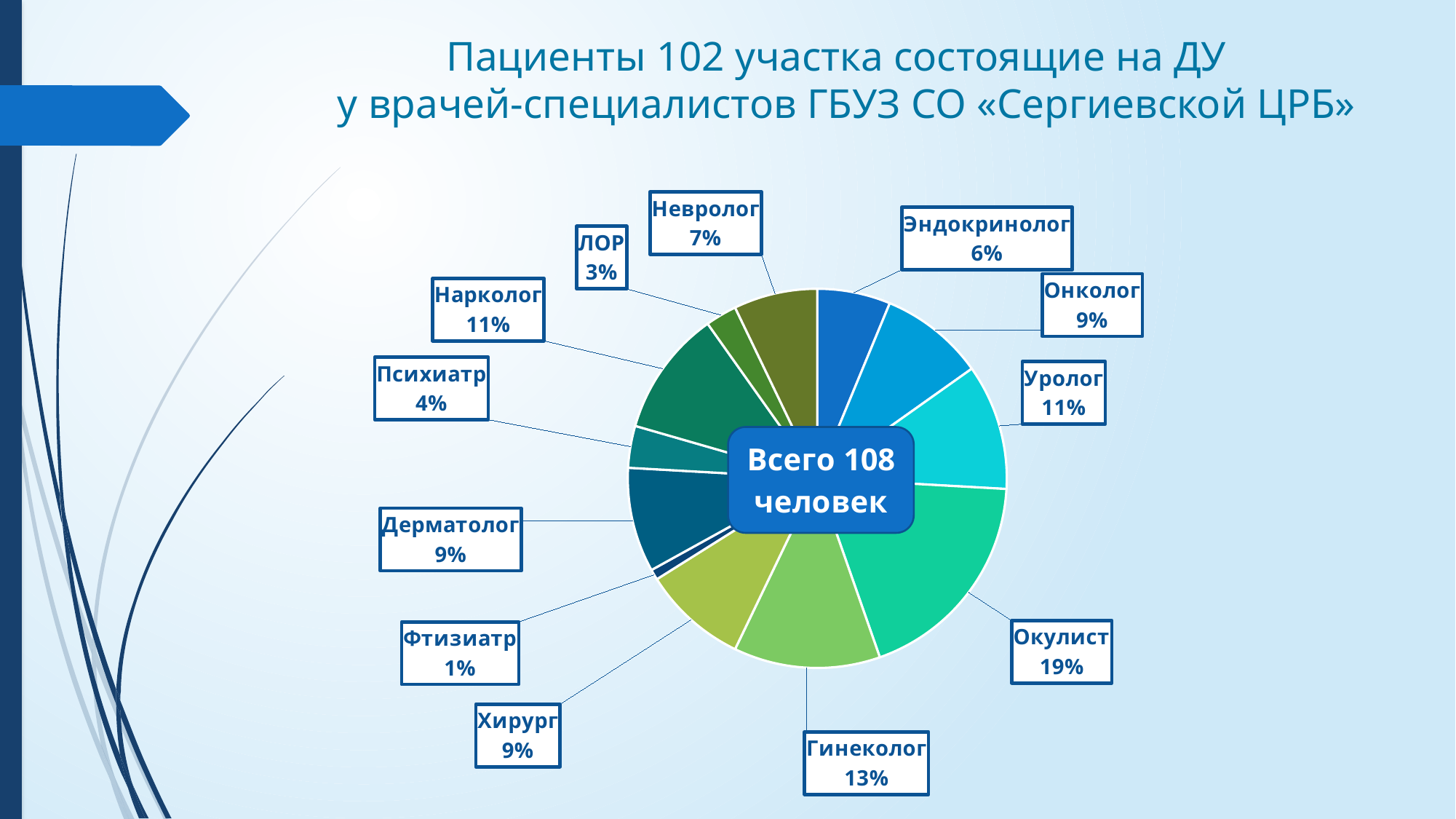
Which specialist has the largest share of patients in the pie chart? Окулист Which has a larger share, Невролог or Эндокринолог? Невролог What share of patients is shown for Фтизиатр? 1% What is the difference in percentage points between Уролог and ЛОР? 8 Which specialist has the smallest share of patients in the pie chart? Фтизиатр What is the difference in percentage points between Окулист and Гинеколог? 6 How many specialist categories are shown in the pie chart? 12 What kind of chart is shown on the slide? pie chart What share of patients is shown for Нарколог? 11% What share of patients is shown for Гинеколог? 13% What share of patients is shown for Окулист? 19% What total number of people is stated in the centre of the pie chart? Всего 108 человек